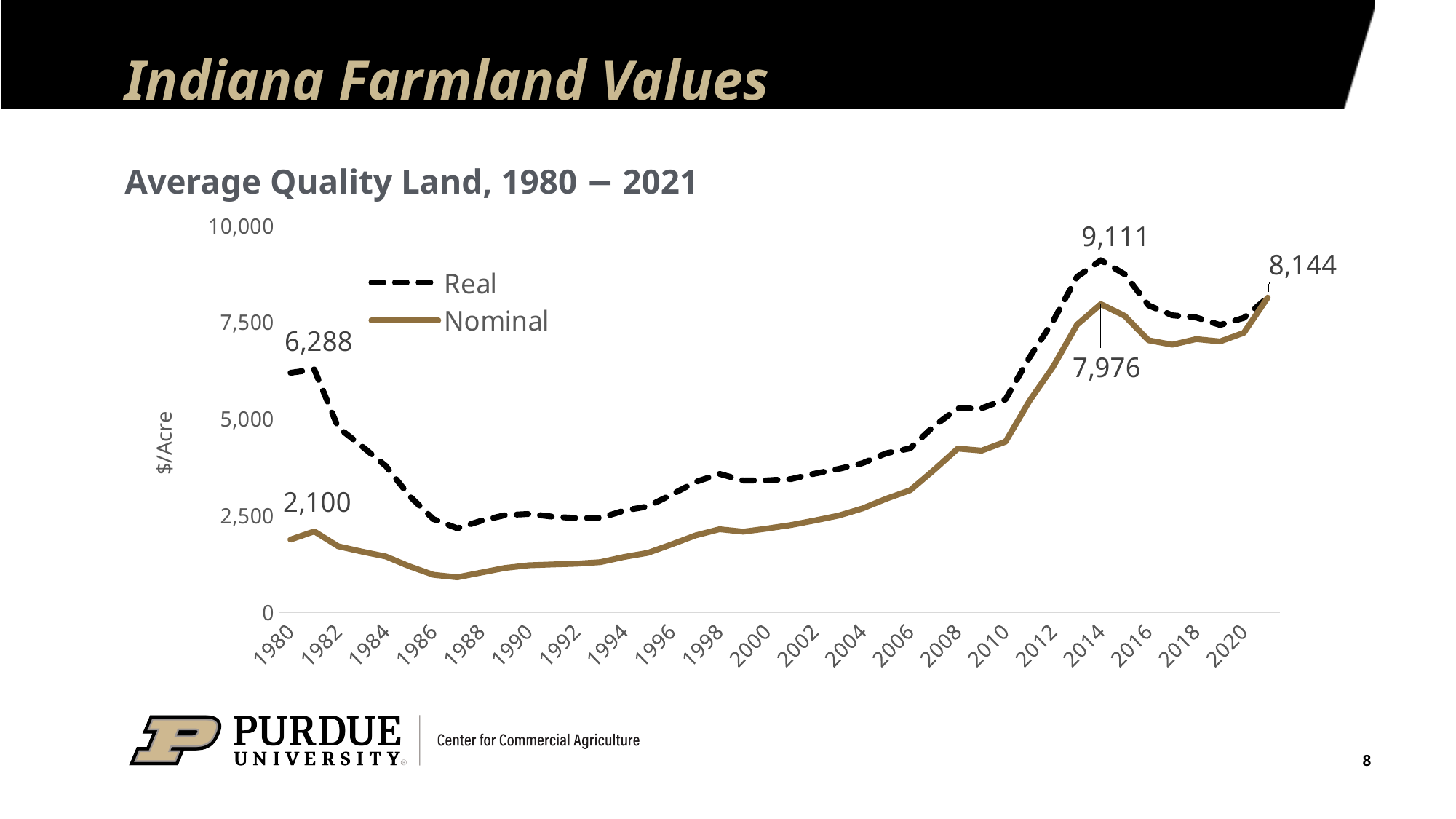
Is the Nominal value in 1987 greater or less than 2,500? less What is the difference between the Real and Nominal values in 2014? 1,135 What kind of chart is shown on the slide? Line chart How many series does the legend list? 2 What is the labeled Nominal value in 2014? 7,976 In 1980, which series has the larger value, Real or Nominal? Real In which year does the Real series reach its highest value? 2014 What value is labeled at the end of the lines in 2021? 8,144 What is the labeled peak value of the Real series in 2014? 9,111